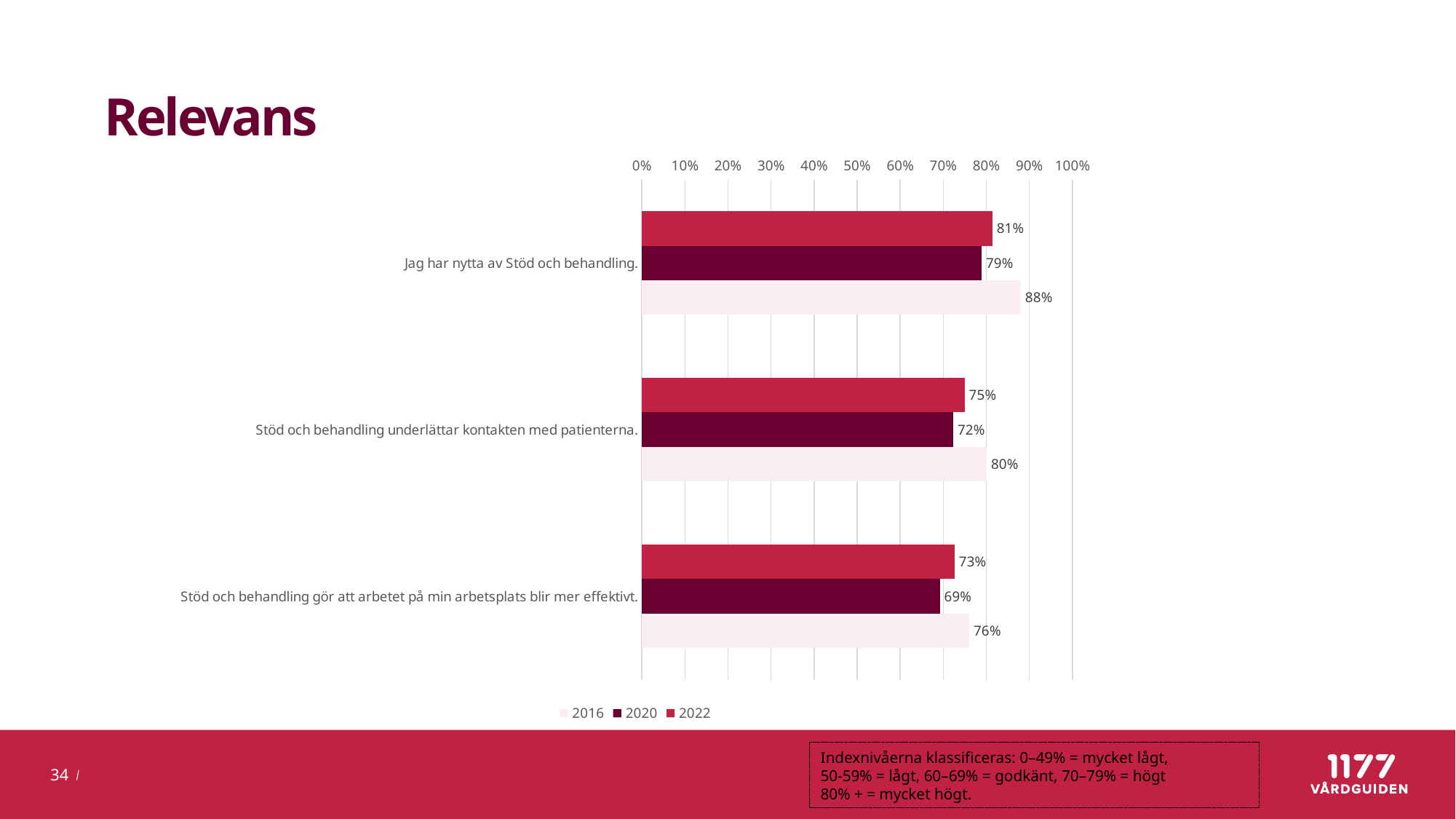
Which category has the highest 2016 value? Jag har nytta av Stöd och behandling. How many categories are shown on the chart? 3 What is the difference between the 2022 and 2020 values for "Stöd och behandling gör att arbetet på min arbetsplats blir mer effektivt."? 4% For "Stöd och behandling underlättar kontakten med patienterna.", which is larger: the 2020 value or the 2022 value? 2022 What is the 2020 value for "Stöd och behandling gör att arbetet på min arbetsplats blir mer effektivt."? 69% How many series does the legend list? 3 What is the 2022 value for "Jag har nytta av Stöd och behandling."? 81% What is the 2016 value for "Stöd och behandling underlättar kontakten med patienterna."? 80% Which year is shown in the darkest colour in the legend? 2020 What kind of chart is shown on the slide? Bar chart Which category has the lowest 2022 value? Stöd och behandling gör att arbetet på min arbetsplats blir mer effektivt. What is the difference between the 2016 and 2022 values for "Jag har nytta av Stöd och behandling."? 7%